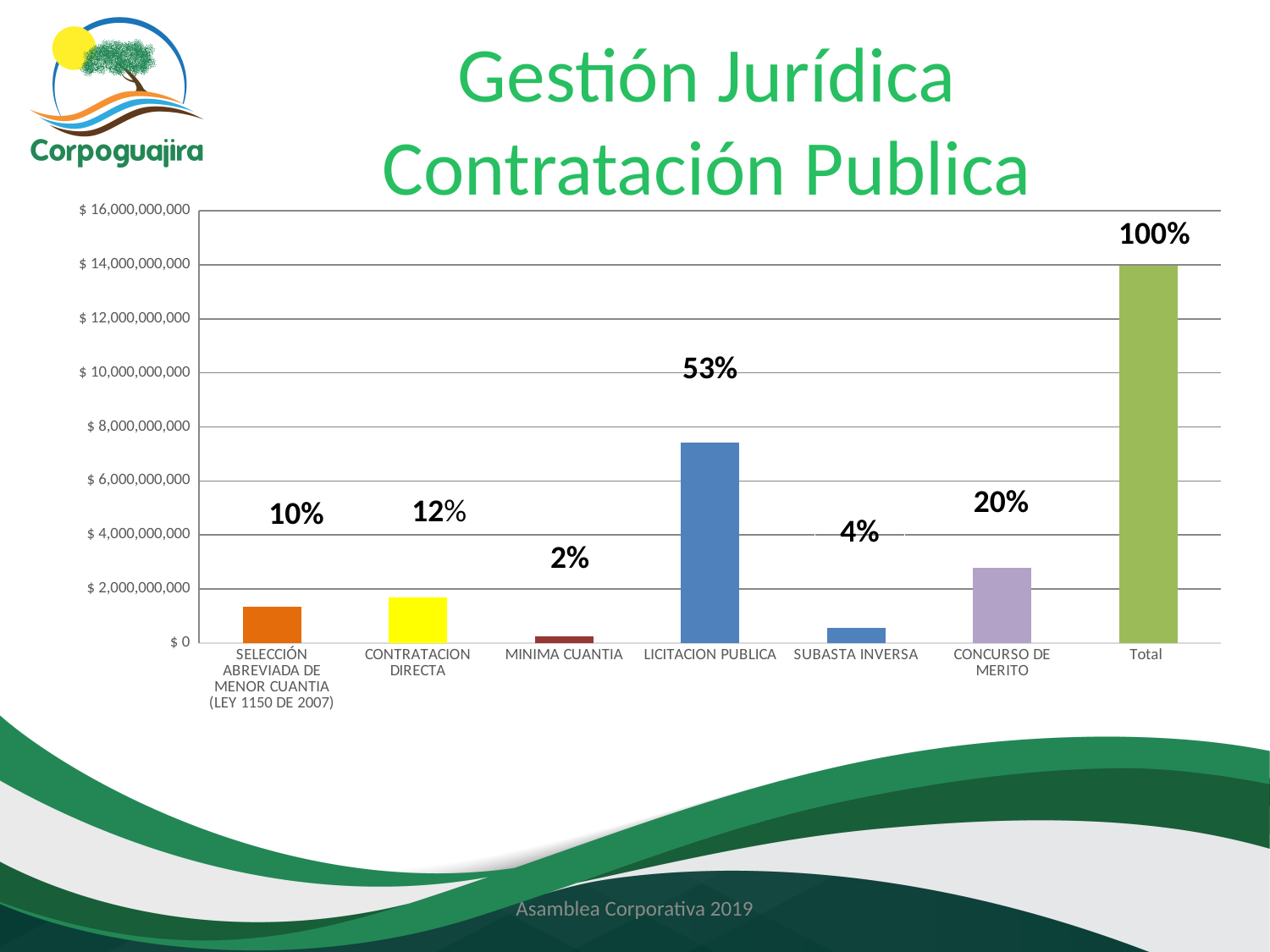
What kind of chart is shown on the slide? Bar chart Excluding the Total bar, which category has the highest value? LICITACION PUBLICA What percentage label is shown for MINIMA CUANTIA? 2% What percentage label is shown for CONCURSO DE MERITO? 20% What percentage label is shown for SUBASTA INVERSA? 4% Which is larger, the value for CONTRATACION DIRECTA or the value for SUBASTA INVERSA? CONTRATACION DIRECTA What is the difference in percentage points between the labels for LICITACION PUBLICA and CONCURSO DE MERITO? 33 Is the value for CONCURSO DE MERITO greater or less than $ 4,000,000,000? less What percentage label is shown for LICITACION PUBLICA? 53% How many bars are shown in the chart, including the Total bar? 7 Is the value for LICITACION PUBLICA greater or less than $ 6,000,000,000? greater Which category has the lowest value? MINIMA CUANTIA